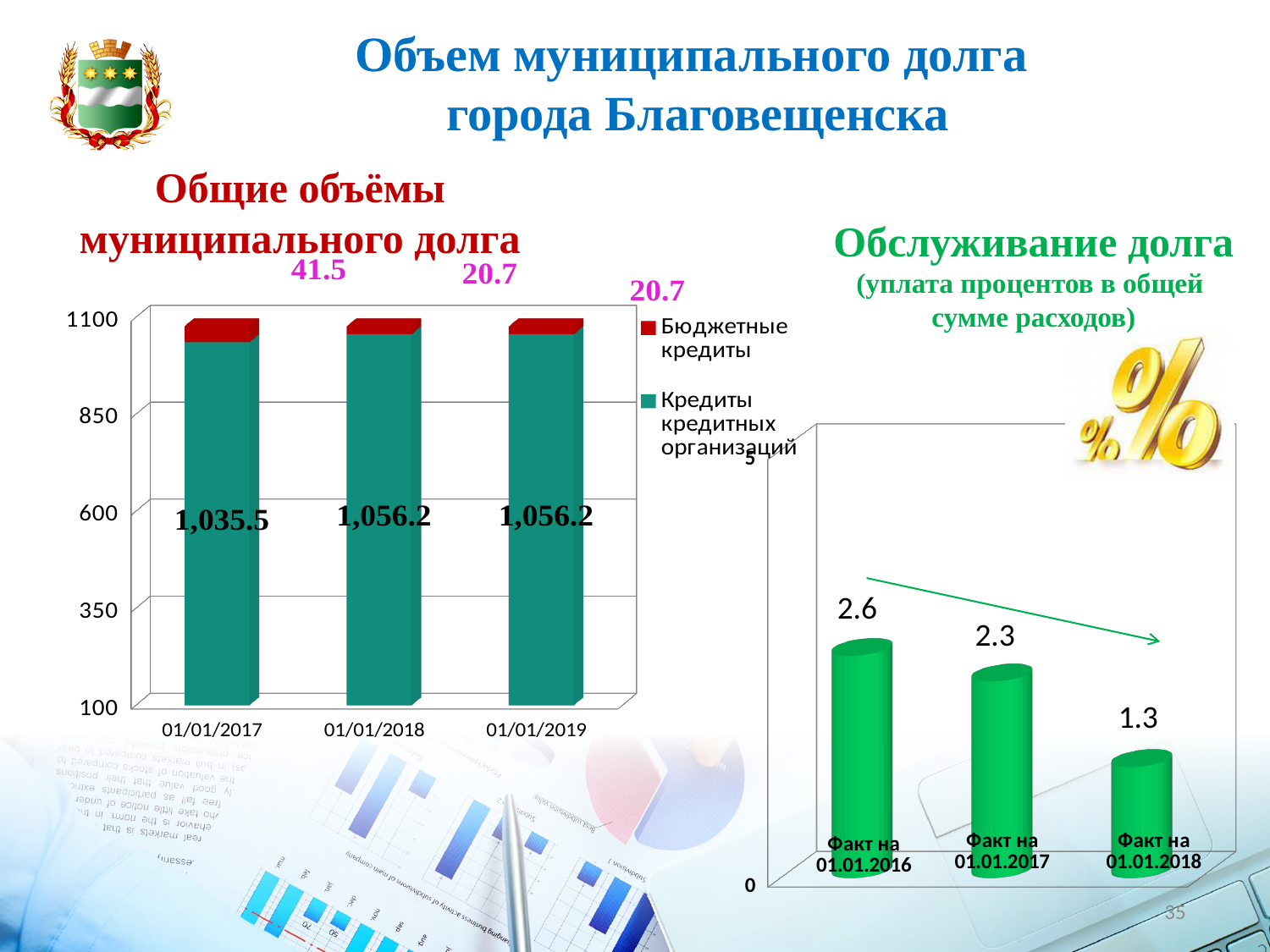
On the chart 'Общие объёмы муниципального долга', what is the difference between the 'Кредиты кредитных организаций' values for 01/01/2018 and 01/01/2017? 20.7 On the chart 'Общие объёмы муниципального долга', how many dates are shown on the x axis? 3 On the chart 'Общие объёмы муниципального долга', what is the value of 'Кредиты кредитных организаций' for 01/01/2019? 1,056.2 On the chart 'Общие объёмы муниципального долга', what is the value of 'Бюджетные кредиты' for 01/01/2017? 41.5 On the chart 'Общие объёмы муниципального долга', which colour represents 'Бюджетные кредиты'? Red On the chart 'Обслуживание долга', which category has the lowest value? Факт на 01.01.2018 On the chart 'Общие объёмы муниципального долга', how many series does the legend list? 2 On the chart 'Обслуживание долга', what is the value for 'Факт на 01.01.2016'? 2.6 On the chart 'Обслуживание долга', what is the difference between the values for 'Факт на 01.01.2016' and 'Факт на 01.01.2018'? 1.3 On the chart 'Обслуживание долга', do the values rise or fall from left to right? Fall On the chart 'Обслуживание долга', what is the value for 'Факт на 01.01.2018'? 1.3 On the chart 'Общие объёмы муниципального долга', what is the value of 'Кредиты кредитных организаций' for 01/01/2017? 1,035.5